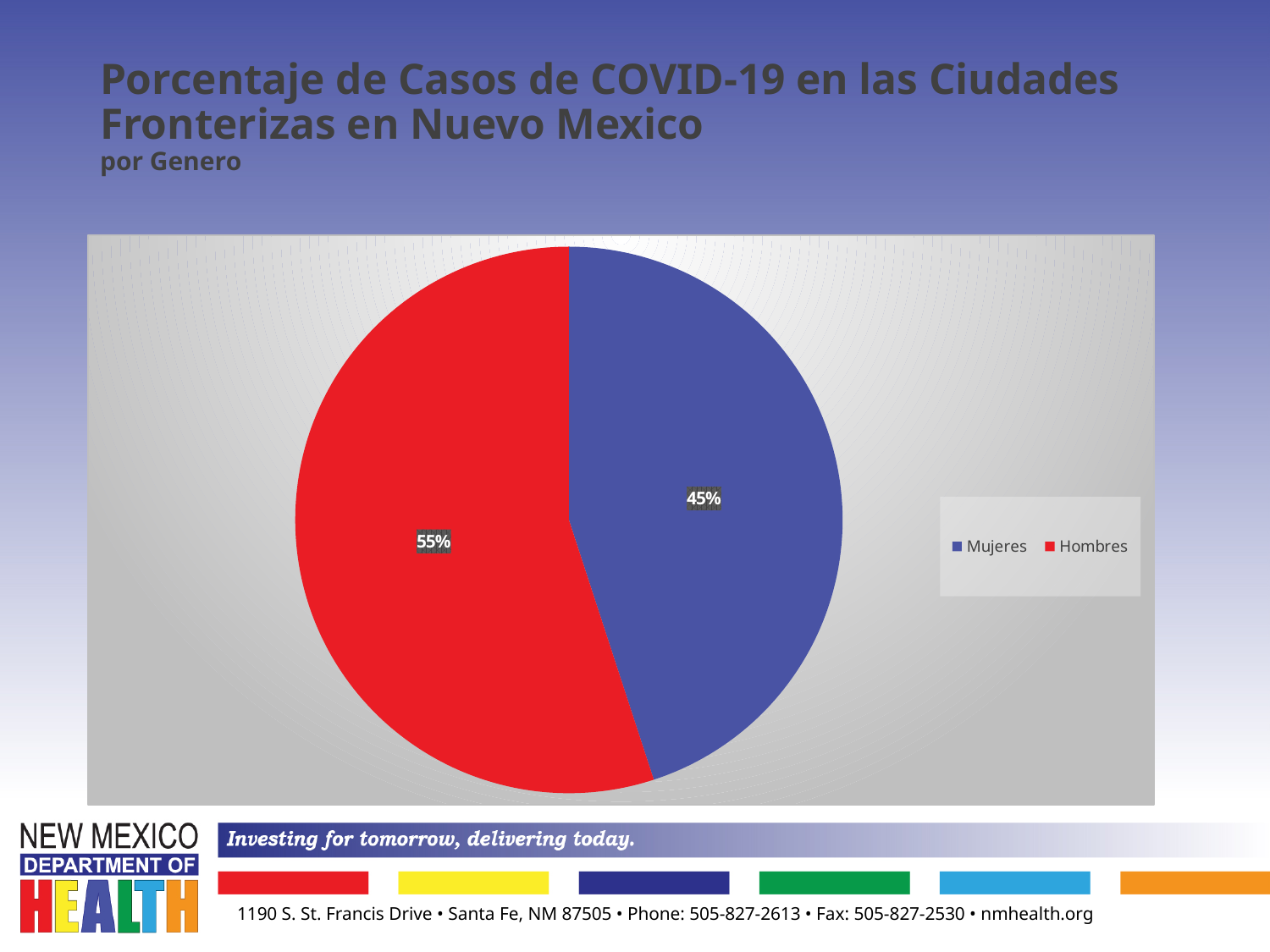
What colour is the Hombres slice? red How many entries does the legend list? 2 What type of chart is shown on the slide? pie chart How many slices does the pie chart have? 2 What percentage of cases is shown for Mujeres? 45% Is the share for Mujeres larger or smaller than the share for Hombres? smaller What colour is the Mujeres slice? blue Which category has the smaller share of the pie? Mujeres What is the difference in percentage points between Hombres and Mujeres? 10% Which category has the larger share of the pie? Hombres What percentage of cases is shown for Hombres? 55%